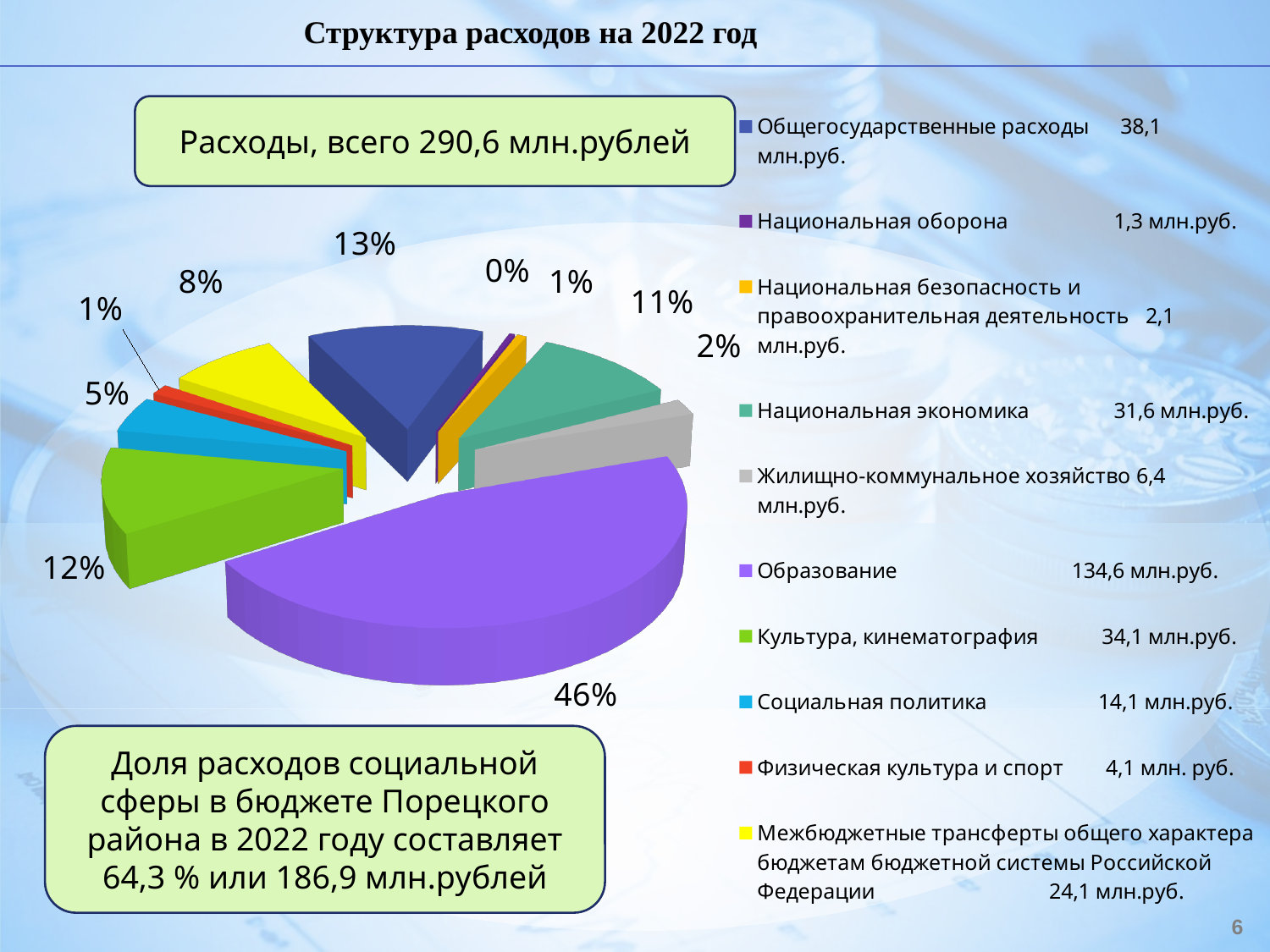
What is the difference between the values for Общегосударственные расходы and Национальная экономика? 6,5 млн.руб. Which is larger: Культура, кинематография or Общегосударственные расходы? Общегосударственные расходы What total expenditure amount is stated in the box above the chart? 290,6 млн.рублей Which category has the smallest slice of the pie? Национальная оборона What kind of chart is shown on the slide? pie chart Which category has the largest slice of the pie? Образование What share of the pie does the largest slice (Образование) represent? 46% How many categories does the legend of the pie chart list? 10 What is the value for Образование according to the legend? 134,6 млн.руб. What share of the pie does Общегосударственные расходы represent? 13% What is the value for Национальная экономика according to the legend? 31,6 млн.руб. What is the value for Социальная политика according to the legend? 14,1 млн.руб.